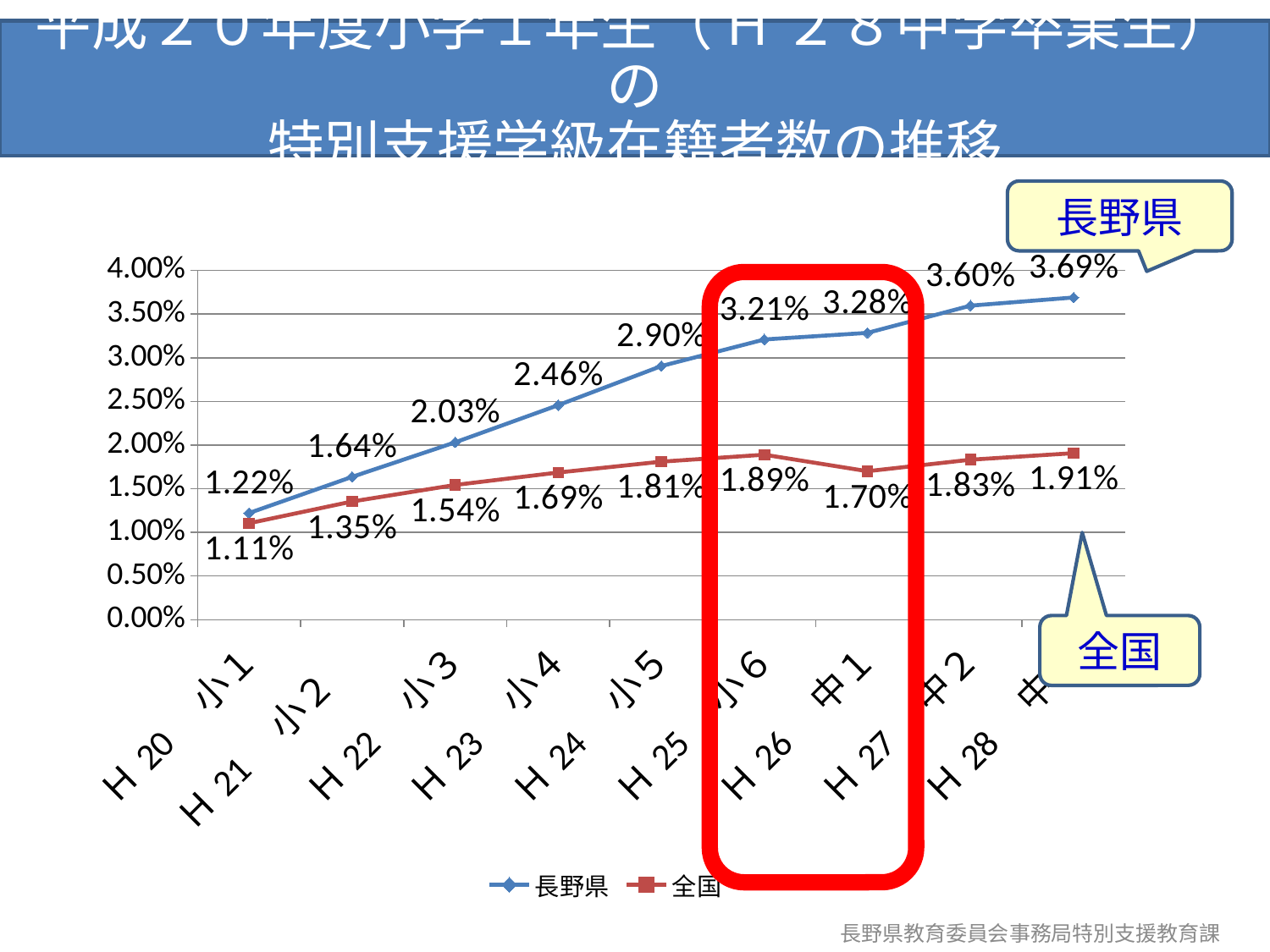
What is the value for 全国 at H26 中1? 1.70% Does the 長野県 series rise or fall from H20 小1 to the last category? Rises How many categories are plotted along the x axis? 9 At H26 中1, how much higher is 長野県 than 全国? 1.58 percentage points What is the value for 長野県 at H20 小1? 1.22% At H24 小5, which series has the larger value, 長野県 or 全国? 長野県 By how much did the 全国 value fall from H25 小6 to H26 中1? 0.19 percentage points What is the value for 全国 at H25 小6? 1.89% At which category is the 全国 value lowest? H20 小1 How many series does the legend list? 2 What is the value for 長野県 at H27 中2? 3.60% What kind of chart is shown on the slide? Line chart